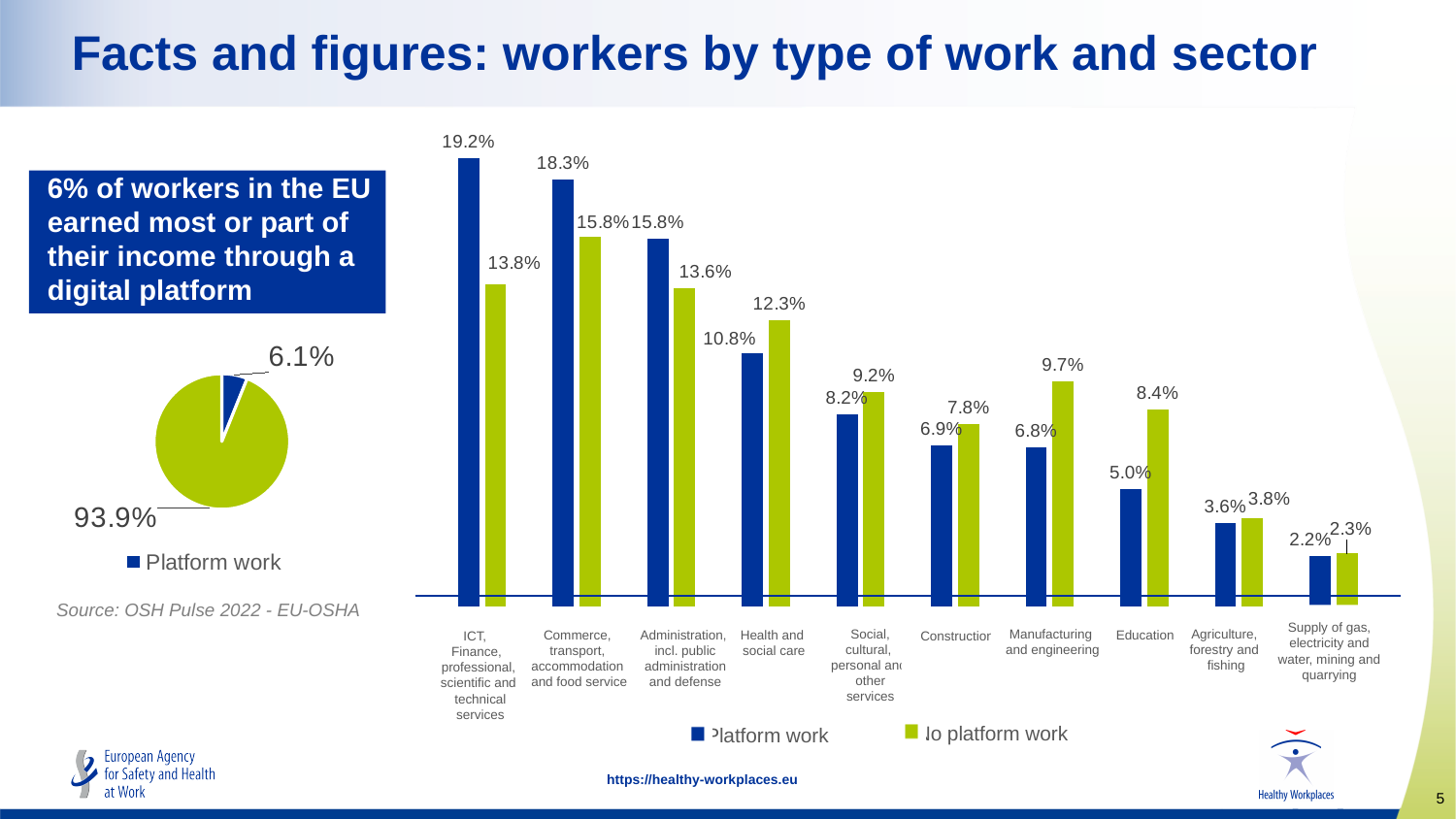
In the bar chart, what is the No platform work value for Manufacturing and engineering? 9.7% What type of chart is the chart on the right side of the slide? Bar chart In the pie chart on the left, what is the value of the larger slice? 93.9% How many series does the bar chart legend list? 2 In the pie chart on the left, what share is labelled for Platform work? 6.1% In the bar chart, for Health and social care, which is larger: Platform work or No platform work? No platform work In the bar chart, do the Platform work values rise or fall from left to right across the sectors? Fall In the bar chart, which sector has the highest Platform work value? ICT, Finance, professional, scientific and technical services In the bar chart, what is the difference between the Platform work and No platform work values for Education? 3.4% How many sectors are shown in the bar chart? 10 In the bar chart, what is the Platform work value for Education? 5.0% In the bar chart, which sector has the lowest No platform work value? Supply of gas, electricity and water, mining and quarrying